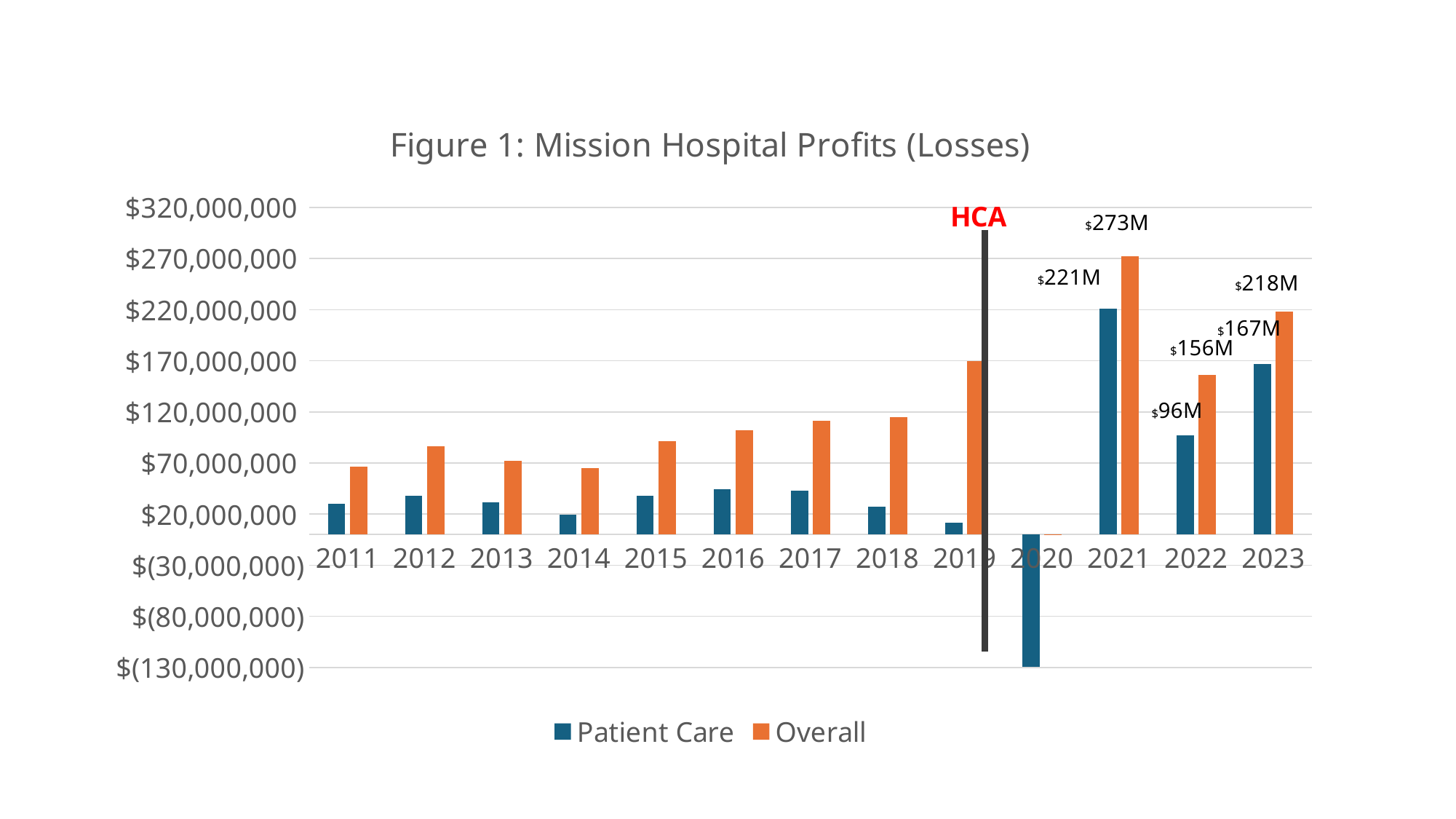
Is the Overall value for 2019 greater or less than $120,000,000? greater How many series does the legend list? 2 What is the Patient Care value for 2023? $167M What is the Patient Care value for 2022? $96M What is the difference between the Overall and Patient Care values in 2021? $52M From 2015 to 2019, do the Overall values rise or fall? rise What is the Overall value for 2021? $273M What kind of chart is shown on the slide? bar chart In 2022, which is larger: Patient Care or Overall? Overall How many years are shown on the x axis? 13 In which year is the Overall value highest? 2021 In which year is the Patient Care value lowest? 2020